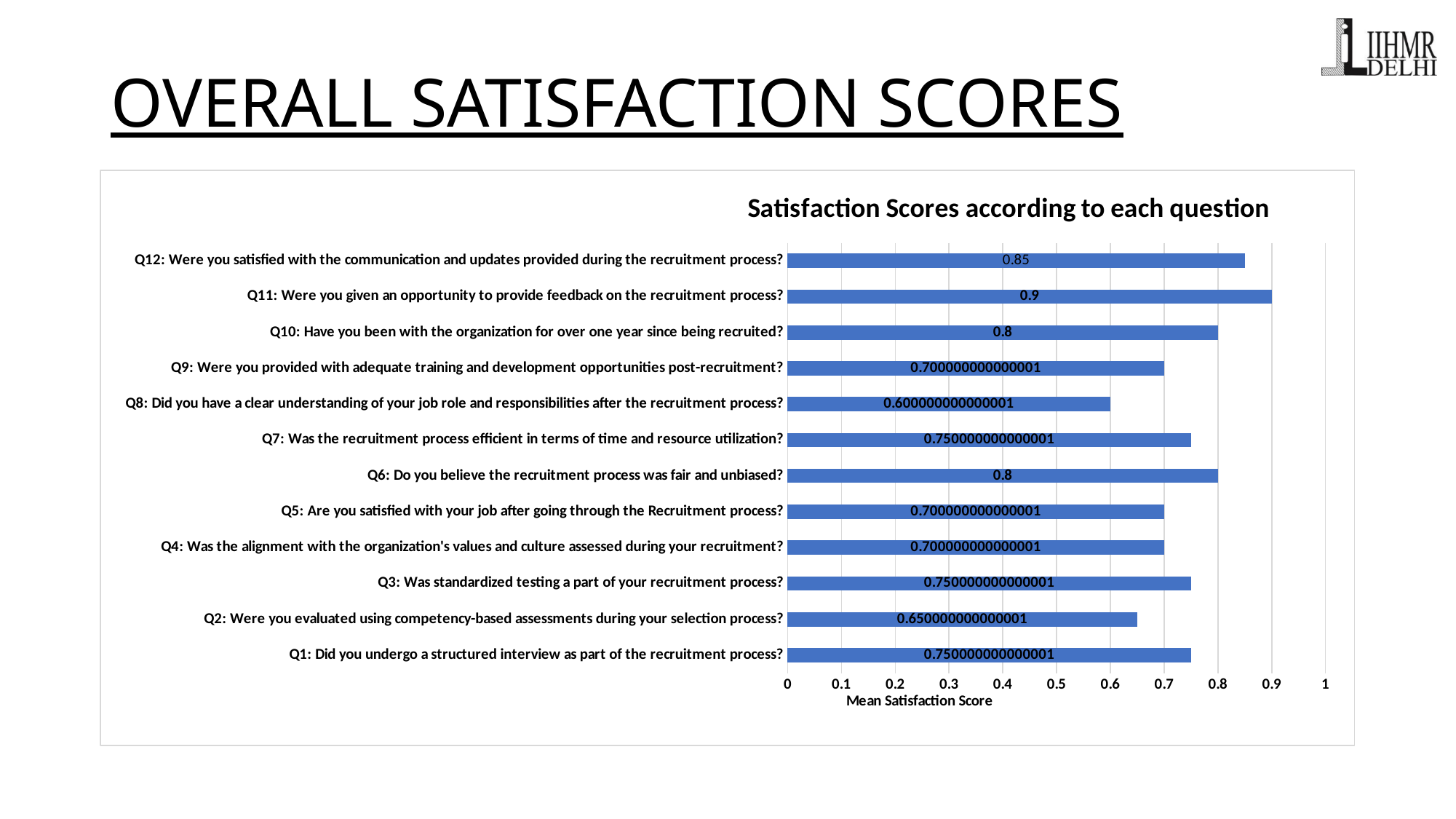
Which question has the lowest mean satisfaction score? Q8 What is the label of the horizontal axis? Mean Satisfaction Score What type of chart is shown on the slide? bar chart What is the mean satisfaction score for Q10? 0.8 What is the mean satisfaction score for Q11? 0.9 What is the data label shown for Q8? 0.600000000000001 Which question has the highest mean satisfaction score? Q11 What is the mean satisfaction score for Q12? 0.85 How many questions (categories) are plotted in the chart? 12 Which has a larger mean satisfaction score, Q2 or Q10? Q10 What is the difference between the mean satisfaction scores of Q11 and Q12? 0.05 What is the title of the chart? Satisfaction Scores according to each question